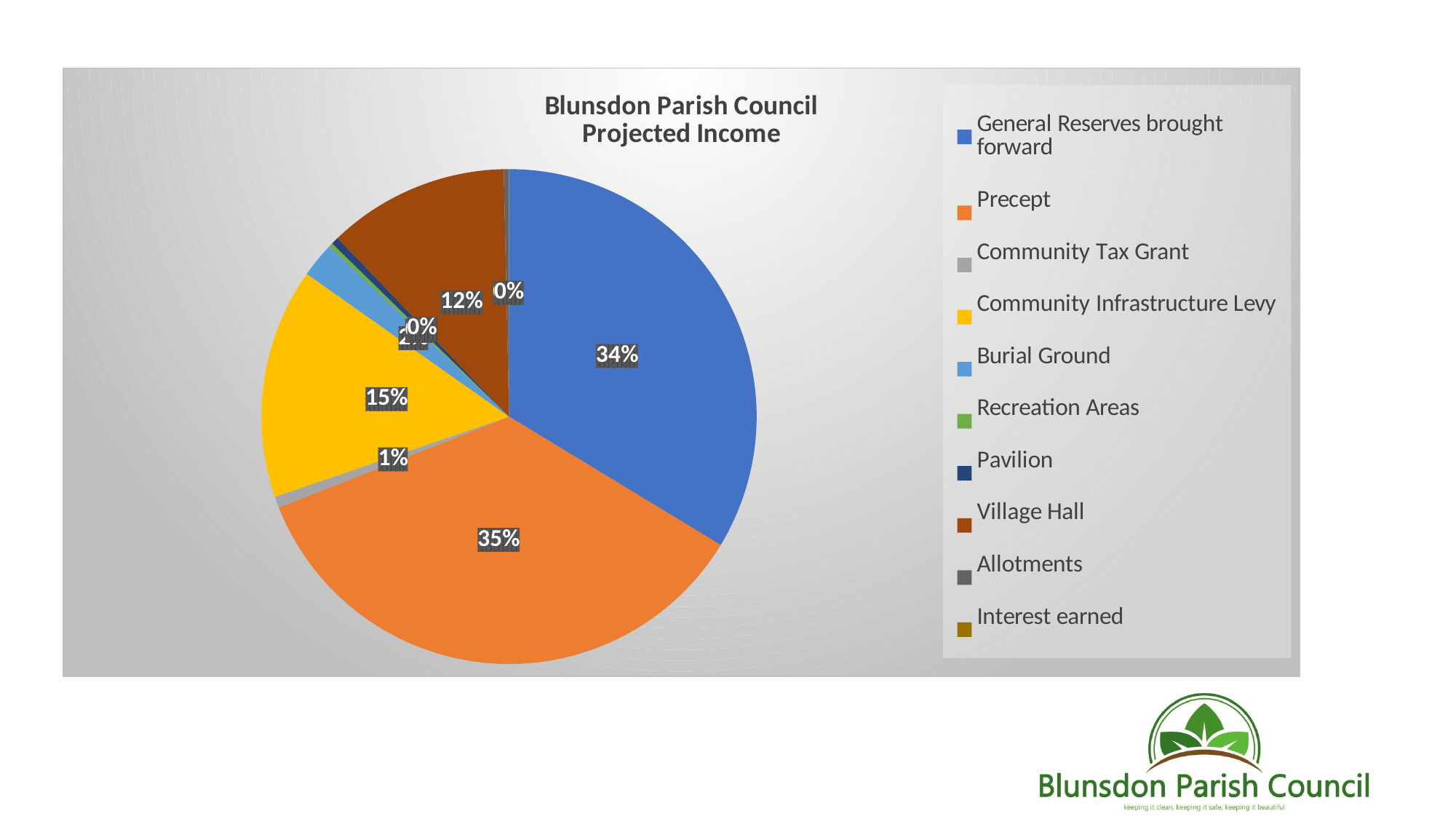
What percentage of projected income comes from the Community Infrastructure Levy? 15% What share of projected income does Precept account for? 35% What is the title of the chart? Blunsdon Parish Council Projected Income By how many percentage points does the Precept share exceed the General Reserves brought forward share? 1 percentage point What share of projected income is General Reserves brought forward? 34% Which is larger: the share for Community Infrastructure Levy or the share for Village Hall? Community Infrastructure Levy What kind of chart is shown on the slide? Pie chart What colour is the Precept slice? Orange What percentage of projected income comes from the Village Hall? 12% Which category has the largest share of projected income? Precept What percentage of projected income is the Community Tax Grant? 1% How many categories does the legend list? 10